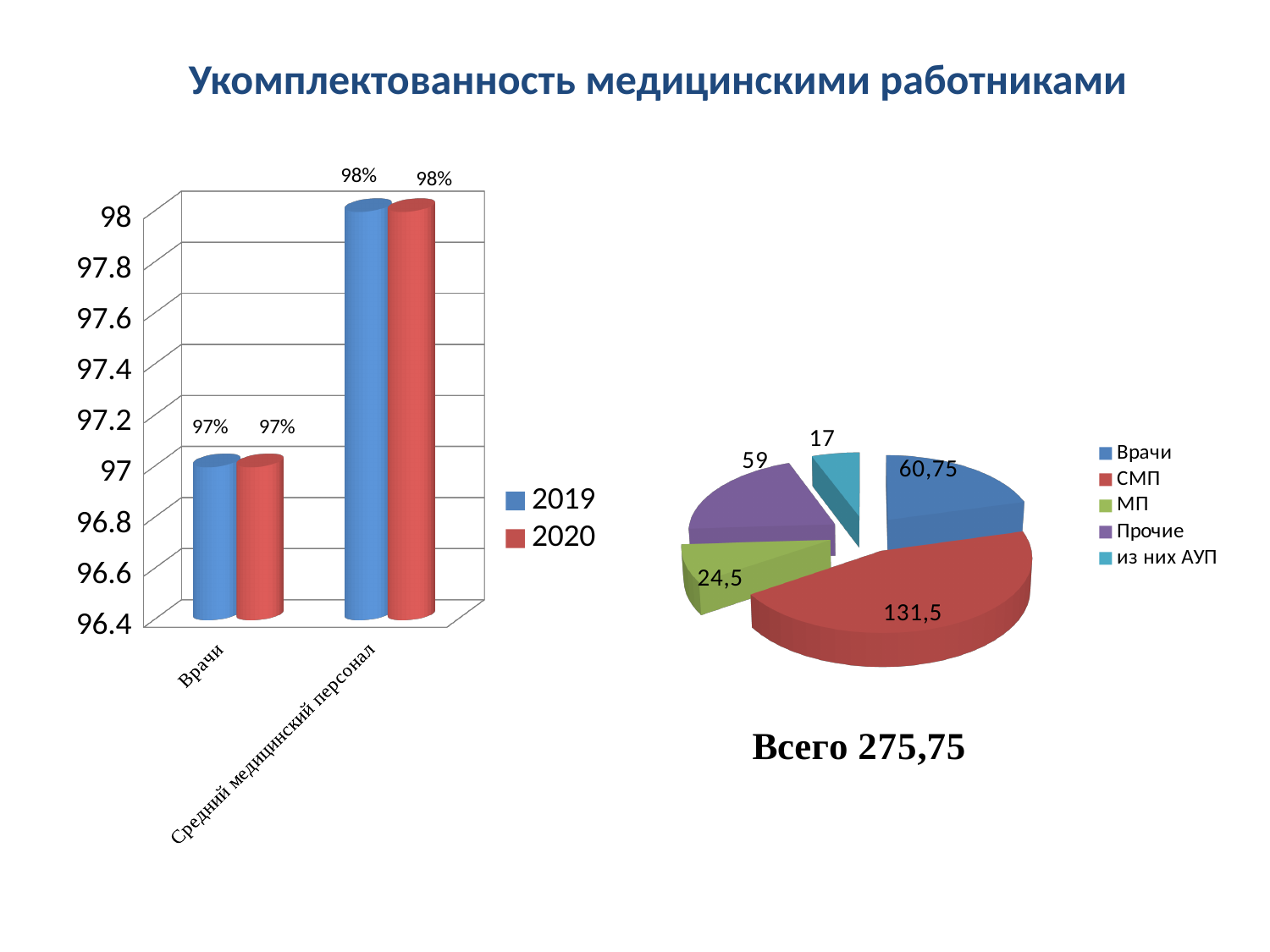
In the right pie chart, what is the value for МП? 24,5 In the left bar chart, what is the value for Врачи in 2019? 97% In the left bar chart, what is the value for Средний медицинский персонал in 2020? 98% What kind of chart is the chart on the right of the slide? pie chart What kind of chart is the chart on the left of the slide? bar chart In the left bar chart, which category has the higher value in 2019? Средний медицинский персонал In the left bar chart, what is the difference between Средний медицинский персонал and Врачи in 2020? 1% How many series does the legend of the left bar chart list? 2 In the right pie chart, which slice is the largest? СМП In the right pie chart, what is the value for СМП? 131,5 What total is printed below the right pie chart? Всего 275,75 In the right pie chart, what is the difference between Прочие and из них АУП? 42